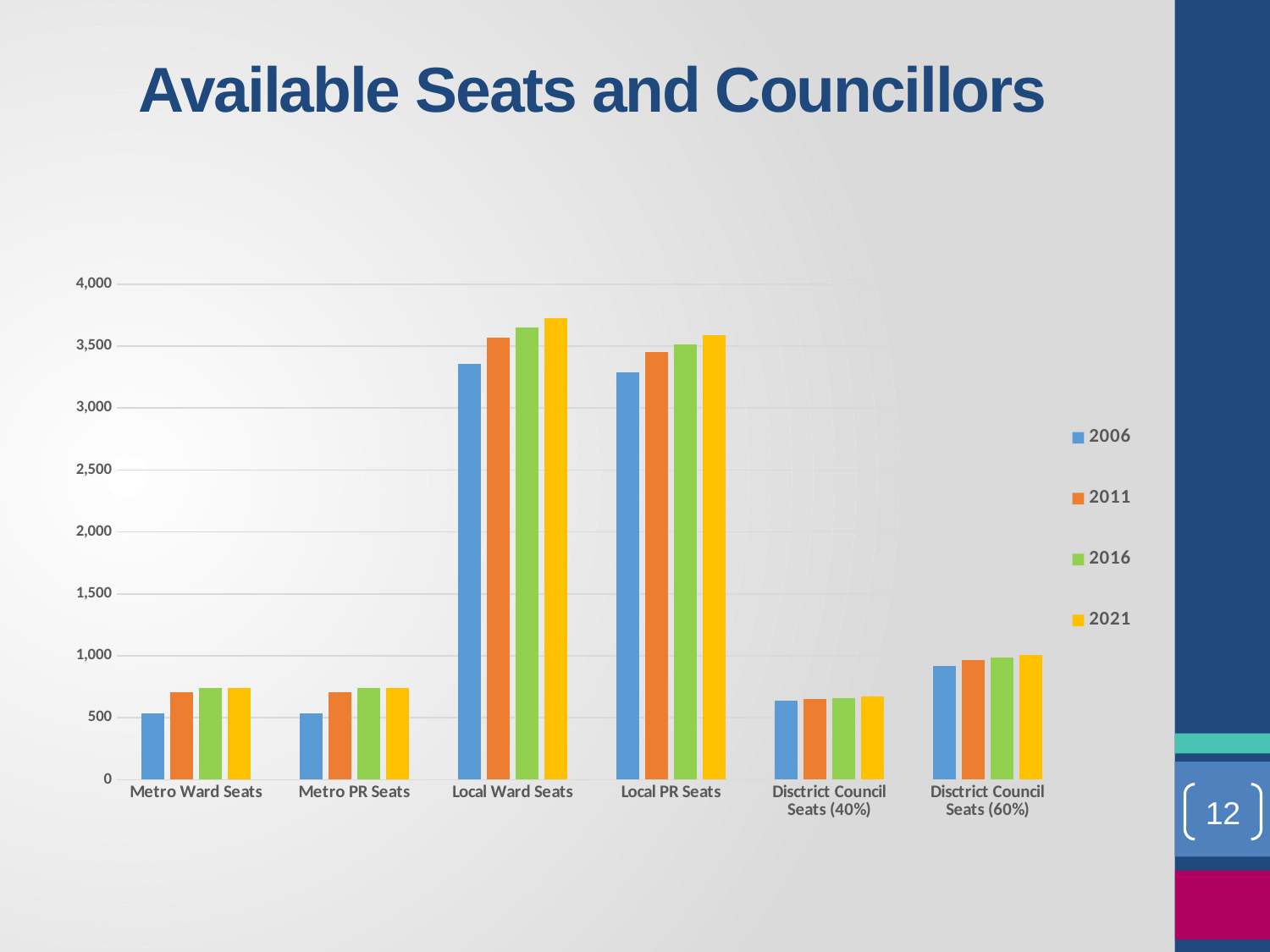
Is the value for Local PR Seats in 2006 greater or less than 3,000? greater Is the value for Local Ward Seats in 2021 greater or less than 3,500? greater How many categories are shown on the x axis? 6 Is the value for Metro Ward Seats in 2006 greater or less than 1,000? less Do the values for Local Ward Seats rise or fall from 2006 to 2021? rise How many series does the legend list? 4 What kind of chart is shown on the slide? bar chart What is the title of the chart? Available Seats and Councillors Which category has the highest value for 2021? Local Ward Seats Which is larger in 2021: Local Ward Seats or Local PR Seats? Local Ward Seats Which colour represents the 2021 series in the legend? yellow